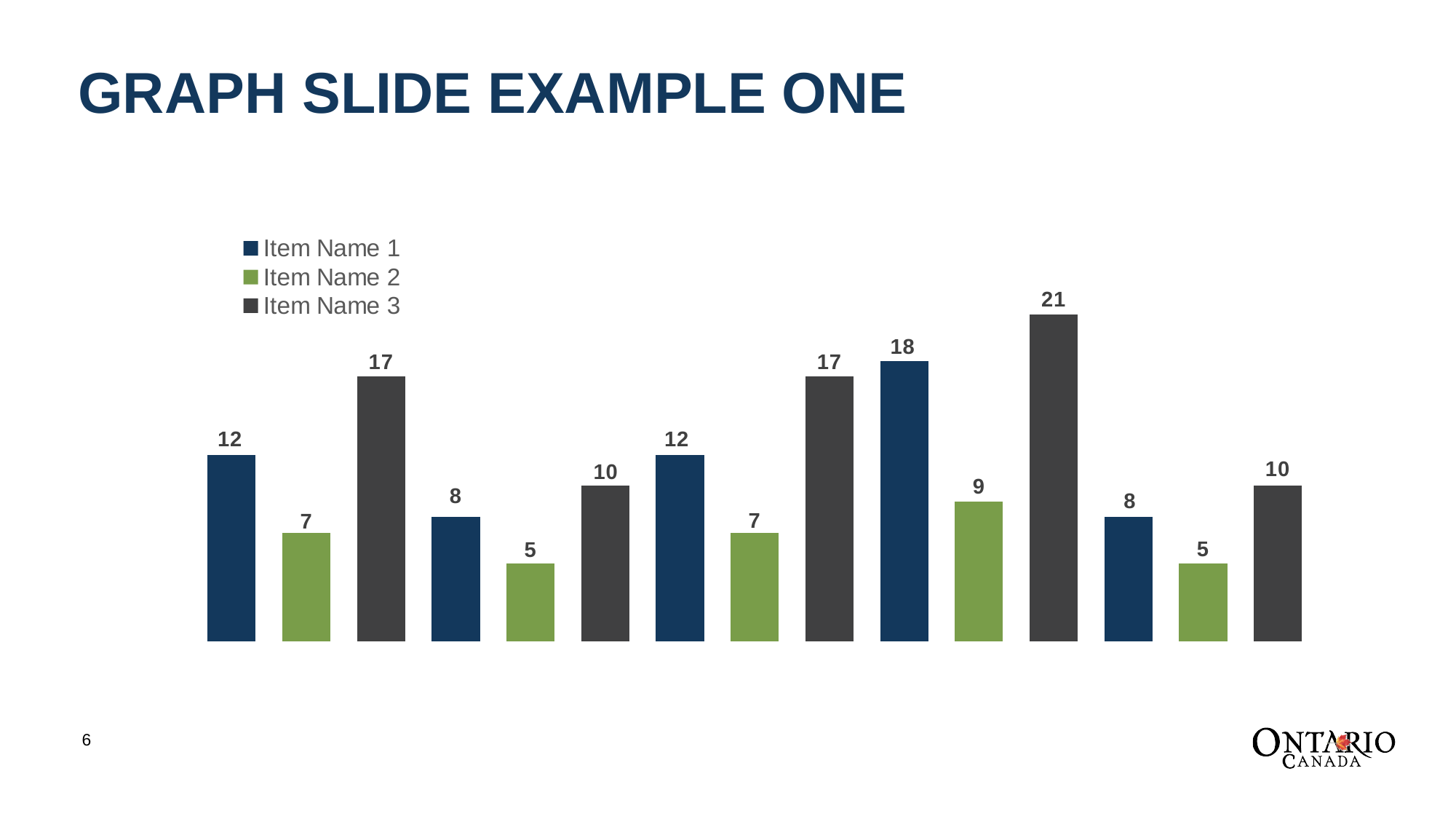
How many series does the legend list? 3 In the first group from the left, which is larger: Item Name 1 or Item Name 2? Item Name 1 What is the value of the Item Name 2 bar in the fourth group from the left? 9 What is the lowest value shown for Item Name 2? 5 What is the highest value shown for Item Name 3? 21 What is the highest value shown for Item Name 1? 18 What is the value of the Item Name 3 bar in the second group from the left? 10 What is the title of the slide containing the chart? GRAPH SLIDE EXAMPLE ONE What is the value of the Item Name 1 bar in the first group from the left? 12 In the fourth group from the left, what is the difference between the Item Name 3 value and the Item Name 1 value? 3 What kind of chart is shown on the slide? Bar chart How many groups of bars are plotted along the x axis? 5